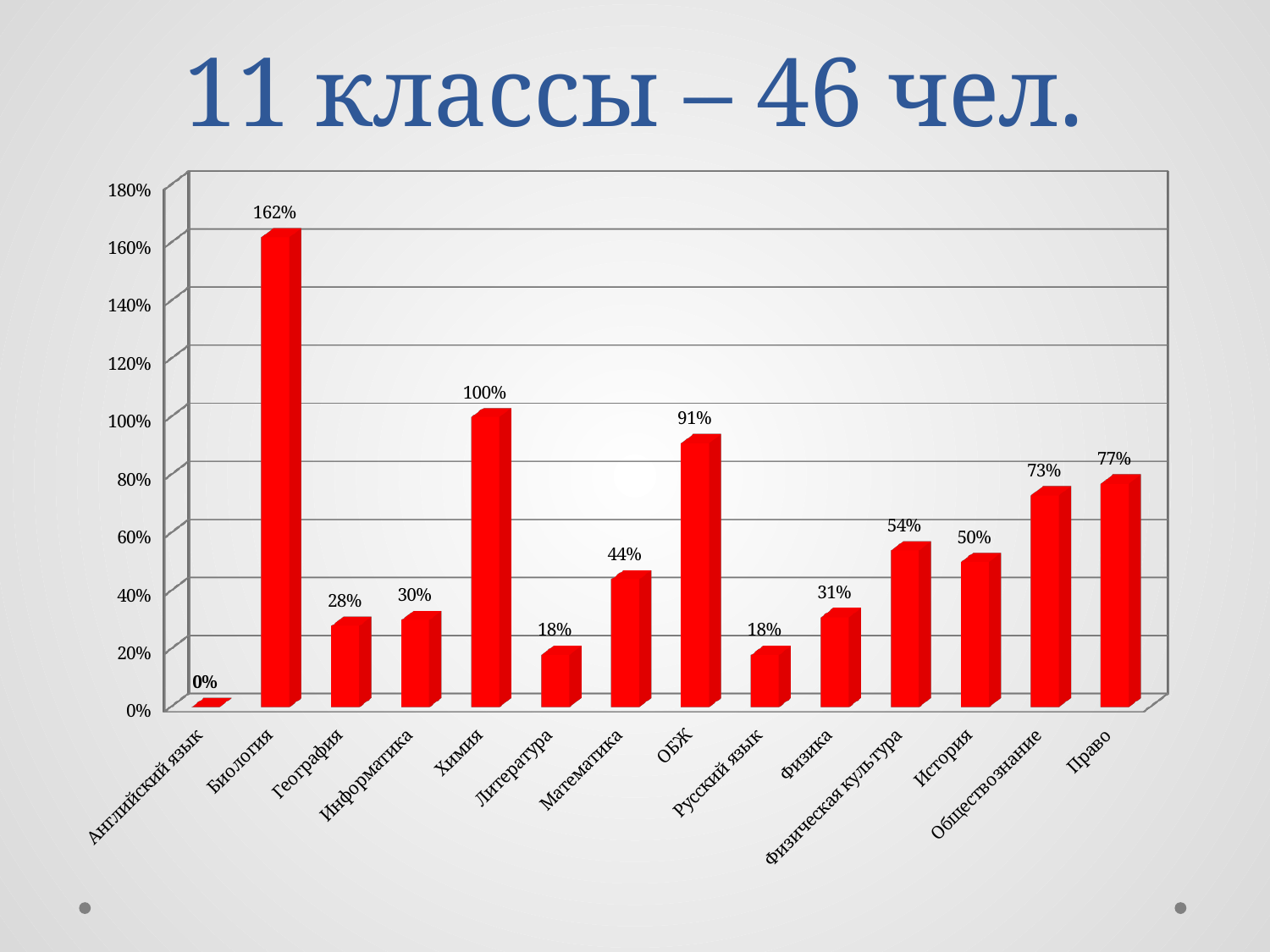
Which category has the highest value? Биология What is the title of the slide? 11 классы – 46 чел. What is the value for ОБЖ? 91% Which category has the lowest value? Английский язык What colour are the bars in the chart? red What is the value for Физическая культура? 54% Which is larger, the value for Обществознание or the value for Право? Право How many categories are shown on the x axis? 14 Is the value for История greater or less than 40%? greater What is the value for Биология? 162% What is the difference between the values for Химия and Математика? 56% What kind of chart is shown on the slide? bar chart